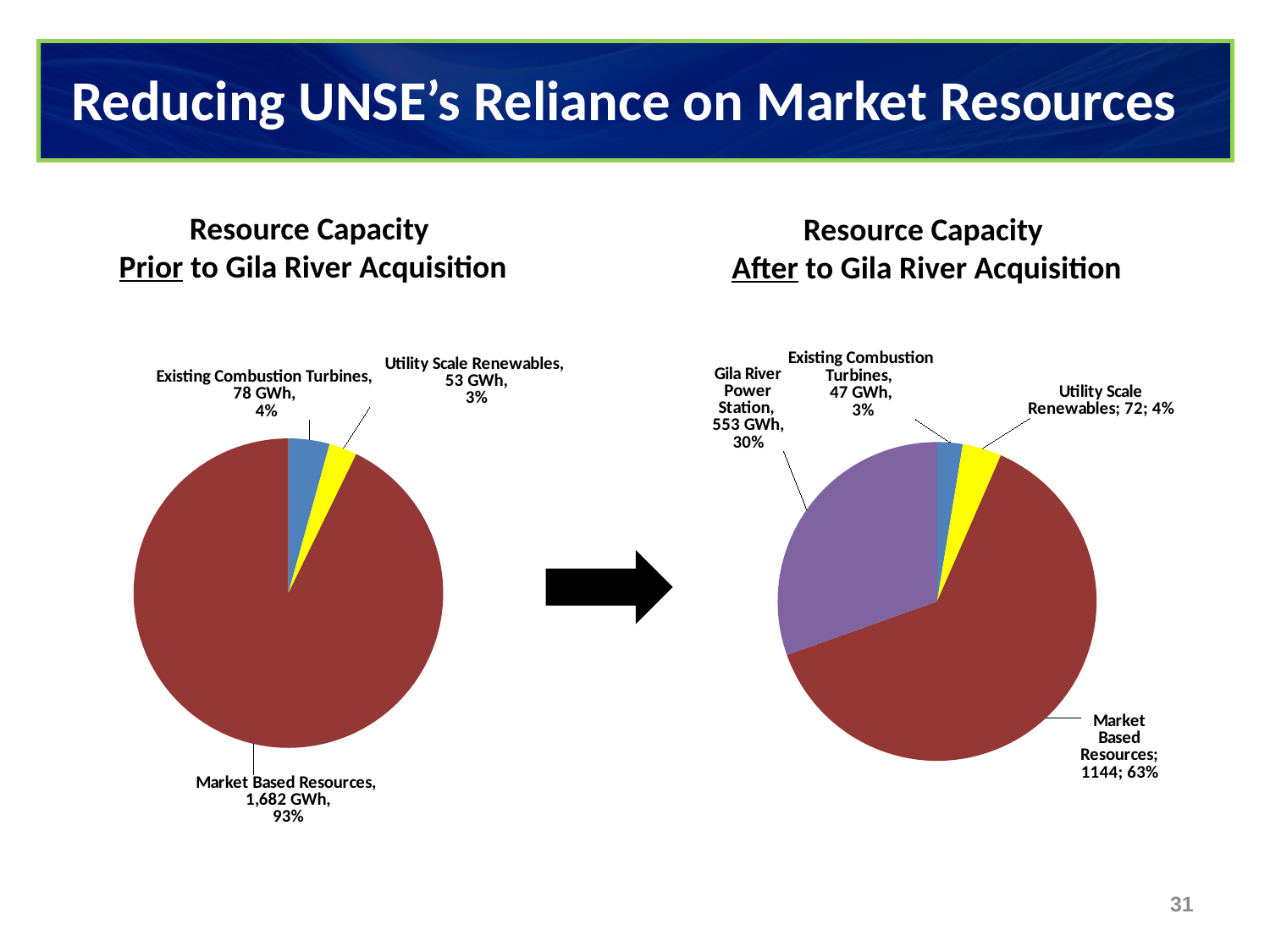
In the 'Resource Capacity Prior to Gila River Acquisition' chart, what is the value for Utility Scale Renewables? 53 GWh In the 'Resource Capacity After to Gila River Acquisition' chart, which is larger, Utility Scale Renewables or Existing Combustion Turbines? Utility Scale Renewables In the 'Resource Capacity After to Gila River Acquisition' chart, what is the value for Gila River Power Station? 553 GWh How many slices does the 'Resource Capacity Prior to Gila River Acquisition' pie chart have? 3 What type of chart is used on the left side of the slide? Pie chart In the 'Resource Capacity Prior to Gila River Acquisition' chart, what is the value for Market Based Resources? 1,682 GWh In the 'Resource Capacity After to Gila River Acquisition' chart, what is the value for Existing Combustion Turbines? 47 GWh In the 'Resource Capacity Prior to Gila River Acquisition' chart, what share of the pie is Existing Combustion Turbines? 4% In the 'Resource Capacity Prior to Gila River Acquisition' chart, which category is the smallest? Utility Scale Renewables In the 'Resource Capacity After to Gila River Acquisition' chart, which category is the largest? Market Based Resources How many slices does the 'Resource Capacity After to Gila River Acquisition' pie chart have? 4 In the 'Resource Capacity After to Gila River Acquisition' chart, what share of the pie is Market Based Resources? 63%